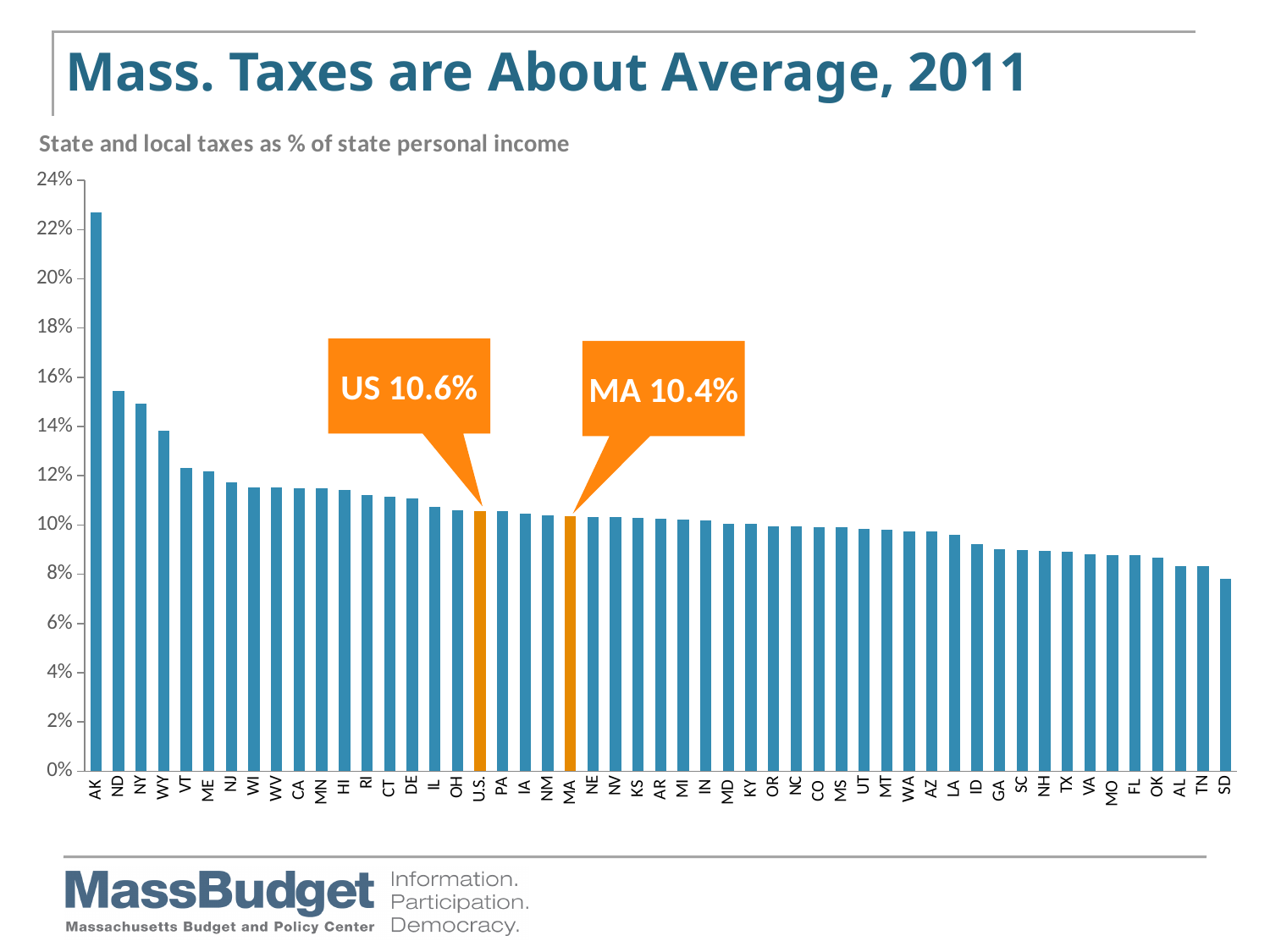
What kind of chart is shown on the slide? bar chart Is the value for AK greater or less than 20%? greater Which state has the lowest state and local taxes as % of personal income? SD What is the value for MA? 10.4% What is the value for U.S. (state and local taxes as % of state personal income)? 10.6% Is the value for NY greater or less than 14%? greater Do the values rise or fall moving from left to right along the x axis? fall What is the difference between the U.S. value and the MA value? 0.2% What is the title of the chart? Mass. Taxes are About Average, 2011 Which state has the highest state and local taxes as % of personal income? AK Is the value for SD greater or less than 10%? less Which is larger, the value for U.S. or the value for MA? U.S.